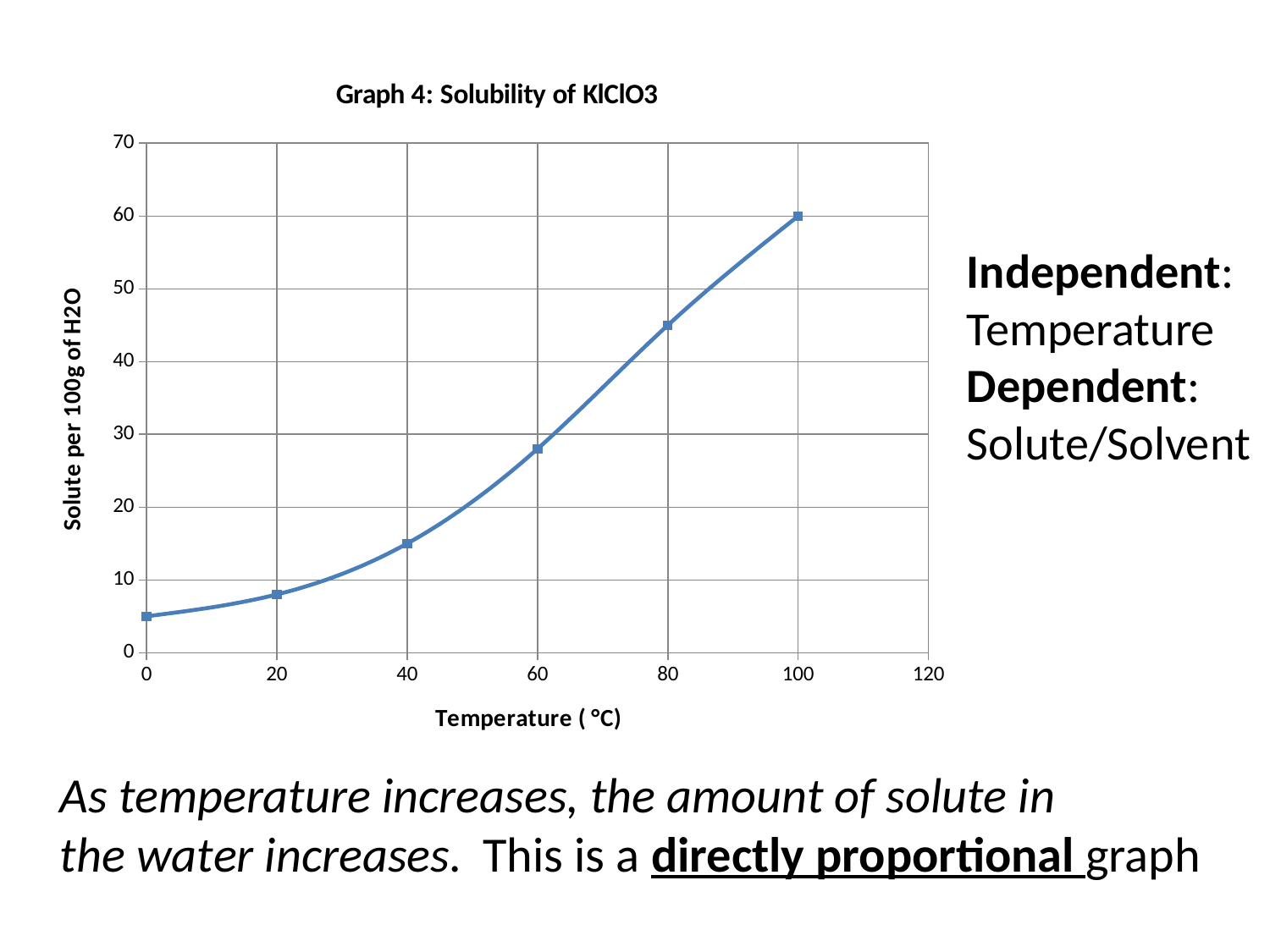
What type of chart is shown on the slide? line chart What is the solute value at a temperature of 100 °C? 60 How many data points are plotted on the line? 6 At which temperature is the solute value highest? 100 Is the solute value at 80 °C greater or less than 40? greater What is the title of the chart? Graph 4: Solubility of KlClO3 What is the label of the x axis? Temperature ( °C) Is the solute value at 40 °C greater or less than 10? greater At which temperature is the solute value lowest? 0 Does the amount of solute rise or fall as temperature increases along the x axis? rises Which has the larger solute value, 20 °C or 60 °C? 60 °C Is the solute value at 60 °C greater or less than 30? less